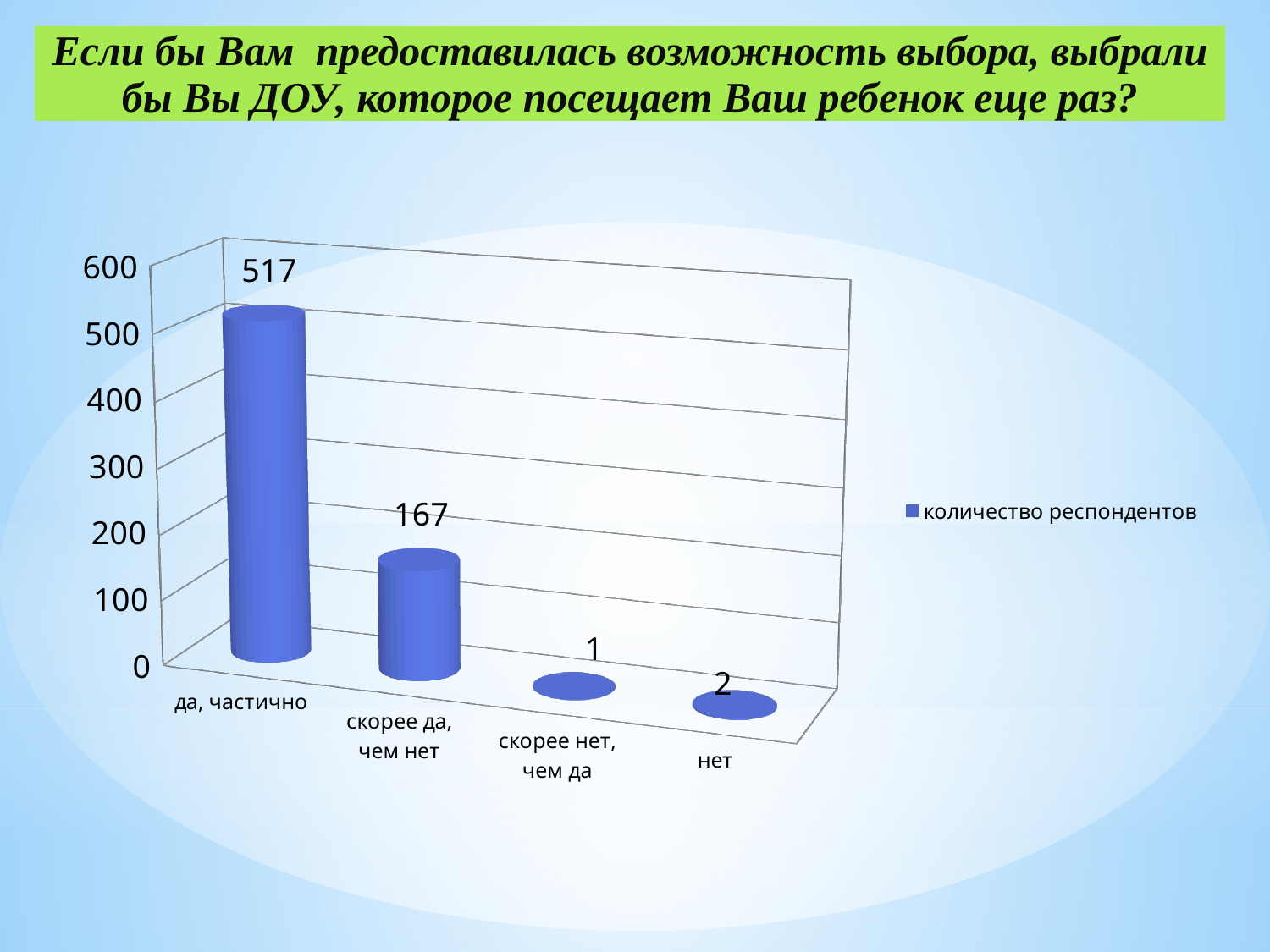
Which category has the highest value? да, частично What is the series name shown in the legend? количество респондентов What is the difference between the values for "да, частично" and "скорее да, чем нет"? 350 How many series does the legend list? 1 What is the value for "скорее нет, чем да"? 1 What is the value for "нет"? 2 How many categories are shown on the x axis? 4 What is the value for "да, частично"? 517 Which is larger, the value for "нет" or the value for "скорее нет, чем да"? нет Which category has the lowest value? скорее нет, чем да What kind of chart is shown on the slide? bar chart What is the value for "скорее да, чем нет"? 167